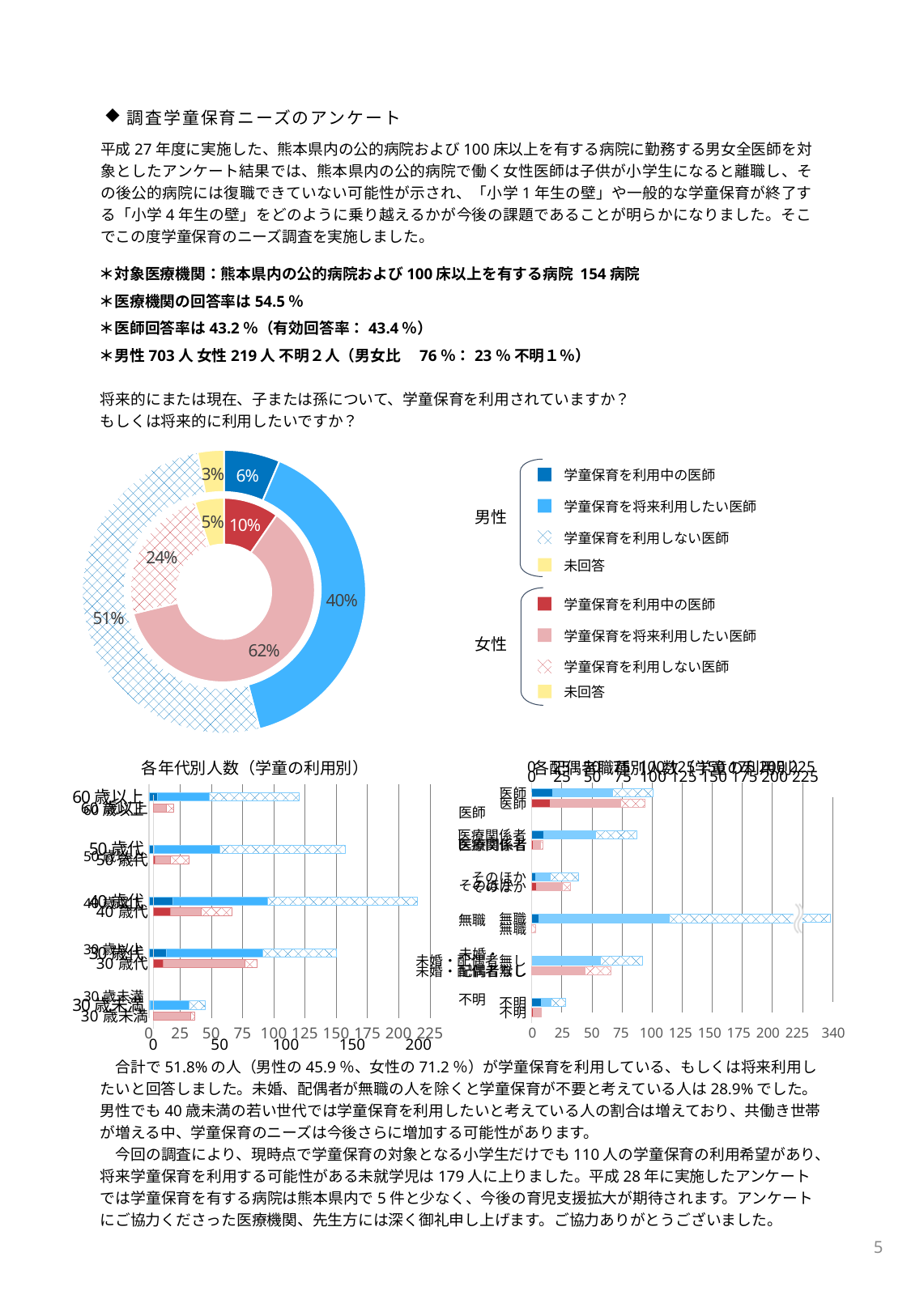
In the doughnut chart, what percentage of male doctors (outer ring) do not use after-school childcare (学童保育を利用しない医師)? 51% In the bar chart on the right (配偶者職種別人数), which category has the longest bar? 無職 How many entries does the legend of the doughnut chart list in total? 8 What kind of chart is the chart titled 各年代別人数（学童の利用別）? Stacked horizontal bar chart In the doughnut chart, what is the 未回答 (no answer) share for male doctors in the outer ring? 3% In the doughnut chart, which is larger: the male share of doctors not using after-school childcare (51%) or the female share (24%)? Male (51%) In the doughnut chart, what is the difference between the female (62%) and male (40%) shares of doctors who want to use after-school childcare in the future? 22 percentage points In the doughnut chart, which category has the largest share in the inner (女性) ring? 学童保育を将来利用したい医師 In the doughnut chart, which category has the largest share in the outer (男性) ring? 学童保育を利用しない医師 In the doughnut chart, what percentage of male doctors (outer ring) want to use after-school childcare in the future (学童保育を将来利用したい医師)? 40% In the doughnut chart, what percentage of female doctors (inner ring) are currently using after-school childcare (学童保育を利用中の医師)? 10% In the doughnut chart, what percentage of female doctors (inner ring) want to use after-school childcare in the future (学童保育を将来利用したい医師)? 62%